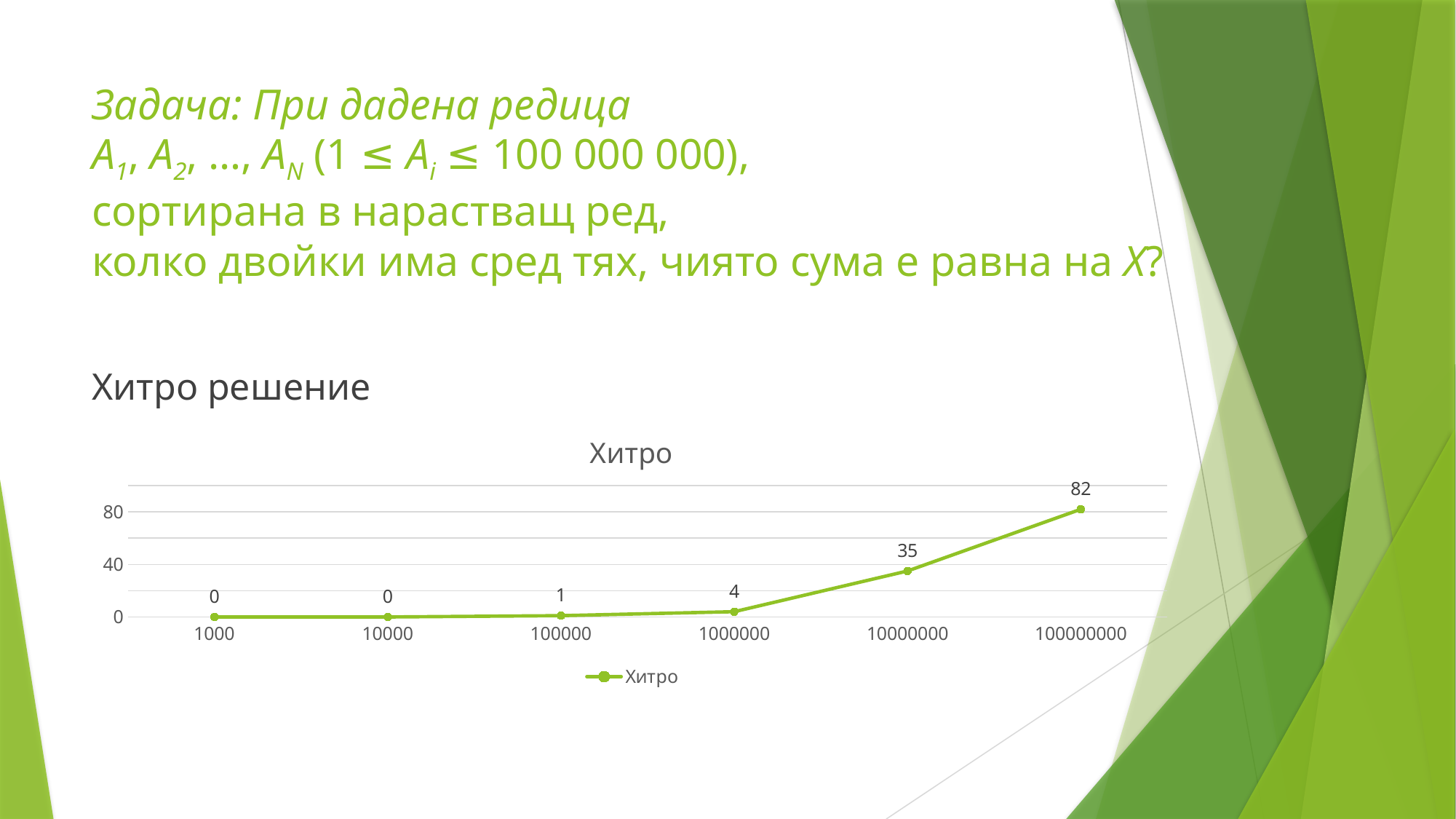
Is the value for 100000000 greater or less than 80? greater What kind of chart is shown on the slide? line chart What is the difference between the values for 100000000 and 10000000? 47 What is the value for 1000000 in the chart? 4 What is the value for 100000 in the chart? 1 How many data points are plotted in the chart? 6 Which category has the highest value? 100000000 What is the value for 100000000 in the chart? 82 How many series does the legend list? 1 What is the value for 10000000 in the chart? 35 Which is larger, the value for 1000000 or the value for 10000000? 10000000 Do the values rise or fall along the x axis? rise